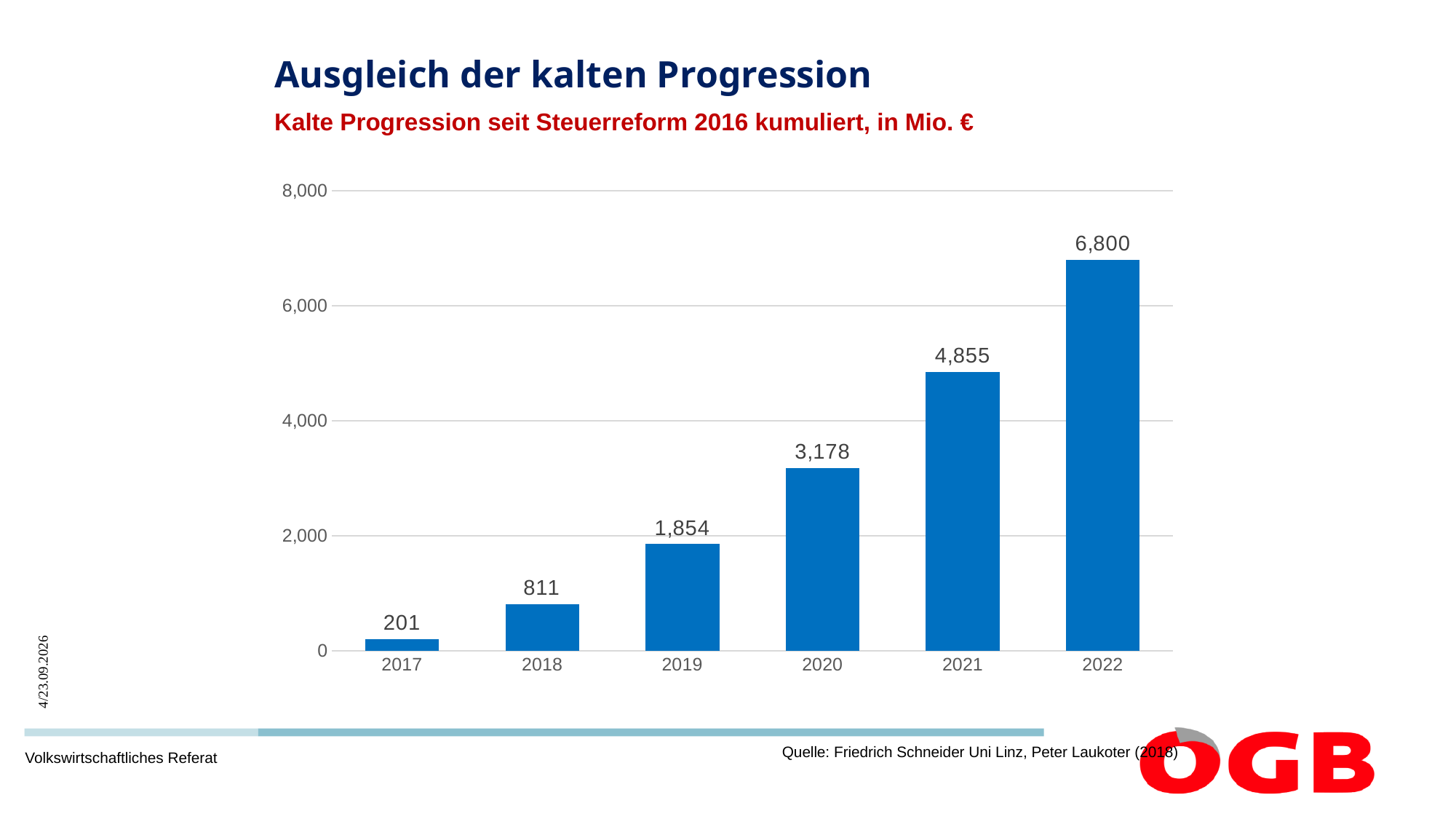
What is the value for 2021? 4,855 How many years are shown on the x axis? 6 Which year has the lowest value? 2017 What kind of chart is shown on the slide? bar chart Which is larger, the value for 2018 or the value for 2020? 2020 What is the difference between the values for 2022 and 2021? 1,945 Do the values rise or fall from 2017 to 2022? rise Which year has the highest value? 2022 What is the value for 2019? 1,854 Is the value for 2021 greater or less than 4,000? greater What is the value for 2017? 201 What is the difference between the values for 2020 and 2019? 1,324